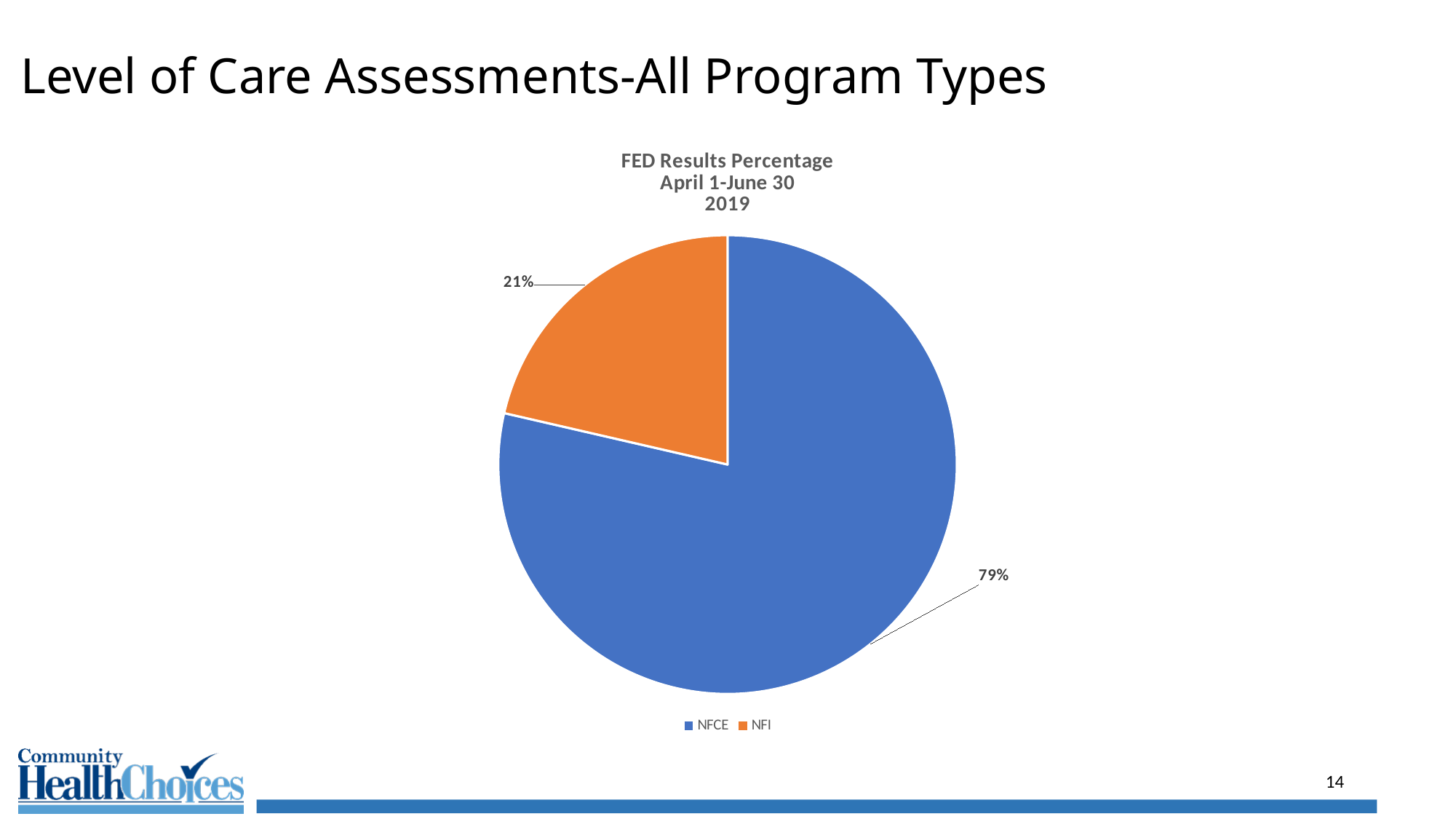
What is the difference in percentage points between the NFCE and NFI slices? 58 What percentage of the pie does NFCE account for? 79% What percentage of the pie does NFI account for? 21% Which category has the smallest share of the pie? NFI How many slices does the pie chart have? 2 What kind of chart is shown on the slide? pie chart How many categories does the legend list? 2 What is the chart's title? FED Results Percentage April 1-June 30 2019 What is the share of the pie for NFCE? 79% Which is larger, the NFCE slice or the NFI slice? NFCE Which category has the largest share of the pie? NFCE What colour is the NFI slice? orange